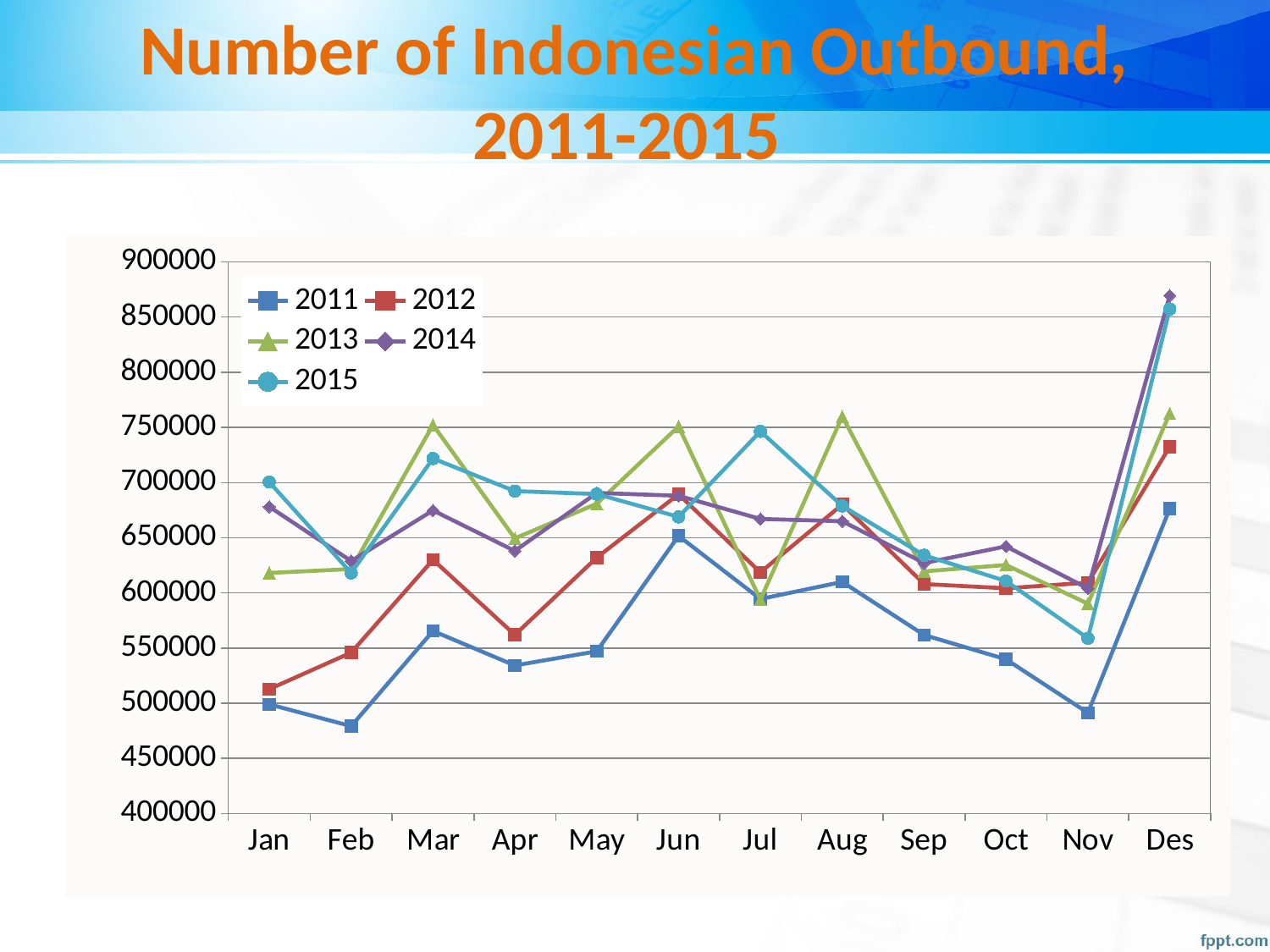
What is the title of the chart? Number of Indonesian Outbound, 2011-2015 Which series has the lowest value in Nov? 2011 How many series does the legend list? 5 Is the value for 2011 in Feb greater or less than 500000? less In Mar, which is larger: the value for 2013 or the value for 2011? 2013 In which month does the 2011 series reach its highest value? Des What kind of chart is shown on the slide? line chart Is the value for 2013 in Jun greater or less than 700000? greater Which series has the highest value in Jul? 2015 How many months are shown along the x axis? 12 Is the value for 2014 in Des greater or less than 850000? greater Does the 2011 series rise or fall from Sep to Nov? fall